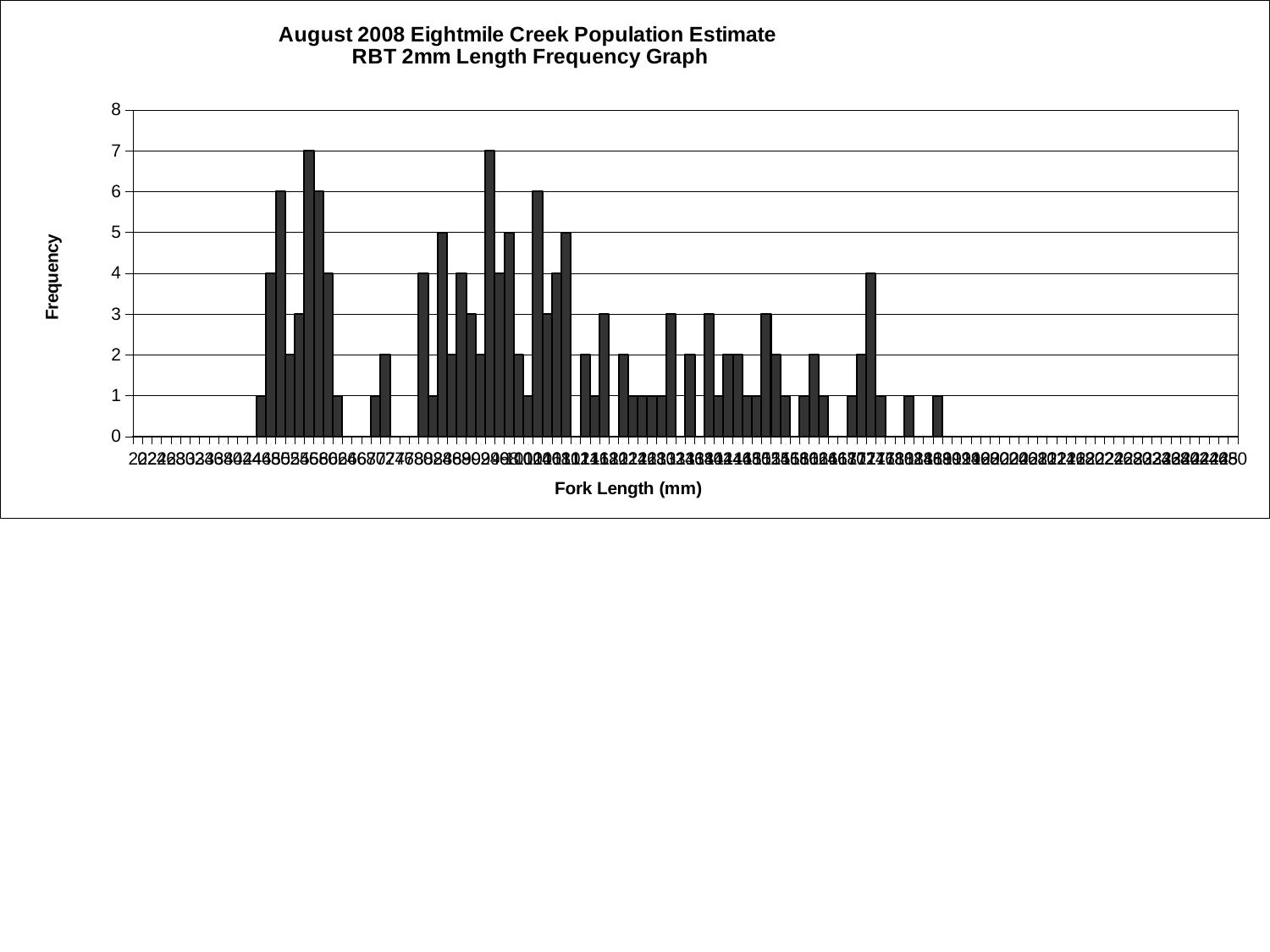
Does any bar in the chart reach a frequency of 8? No What is the highest tick value shown on the Frequency axis? 8 What is the label on the x axis of the chart? Fork Length (mm) What is the title of the chart? August 2008 Eightmile Creek Population Estimate RBT 2mm Length Frequency Graph What kind of chart is shown on the slide? bar chart How many bars in the chart reach a frequency of 7? 2 Is the tallest bar in the chart greater or less than 6? greater What is the highest frequency value reached by any bar in the chart? 7 What is the lowest tick value shown on the Frequency axis? 0